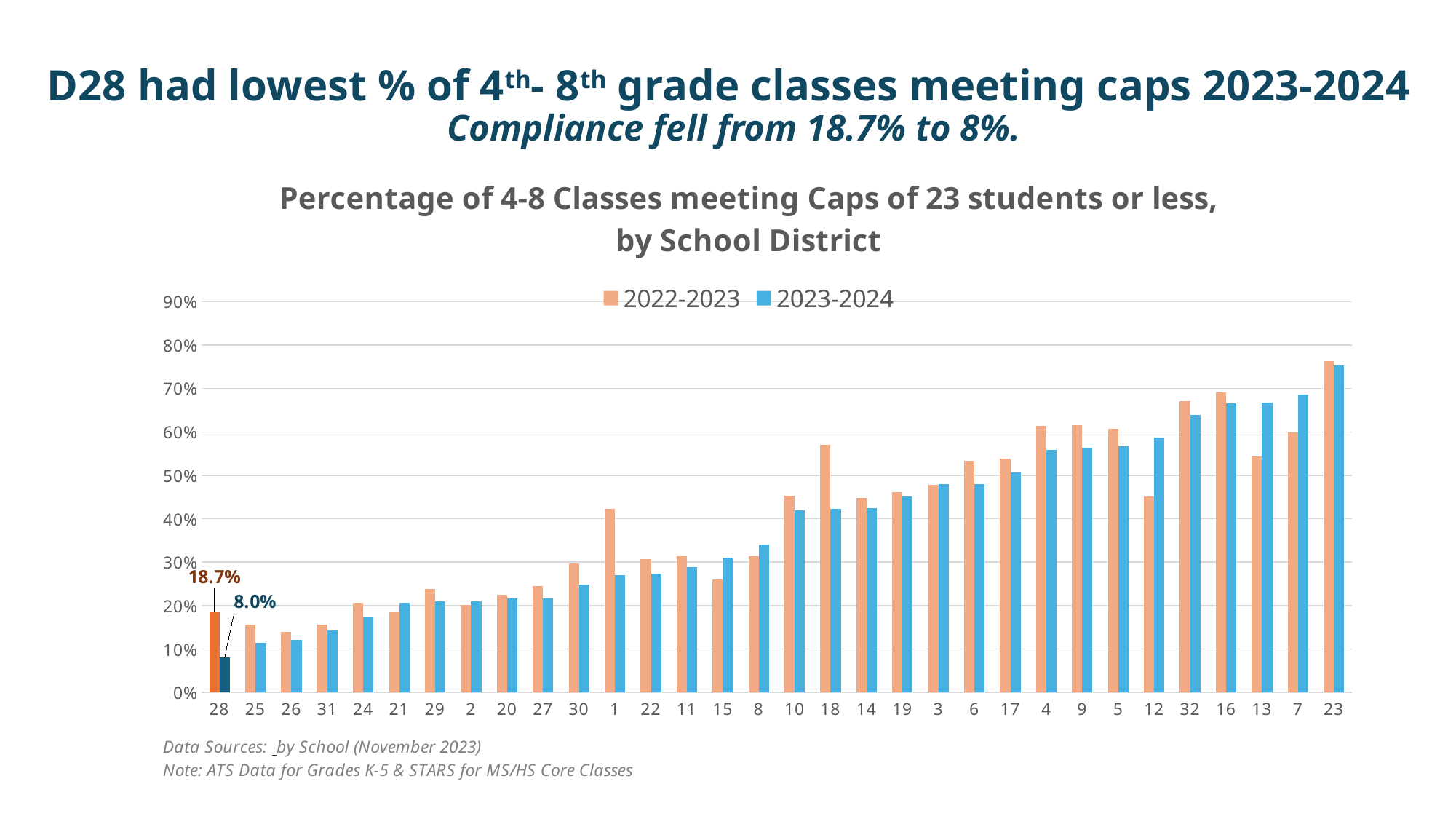
What is the 2022-2023 value for district 28? 18.7% How many series does the legend list? 2 What type of chart is shown on the slide? Bar chart How many school districts are shown on the x axis? 32 Which district has the lowest 2023-2024 value? 28 Is the 2023-2024 value for district 13 greater or less than 60%? greater Is the 2022-2023 value for district 18 greater or less than 50%? greater Which district has the highest 2023-2024 value? 23 By how many percentage points did district 28's value fall from 2022-2023 to 2023-2024? 10.7 percentage points For district 18, which series has the larger value, 2022-2023 or 2023-2024? 2022-2023 Do the values generally rise or fall moving left to right along the x axis? Rise What is the 2023-2024 value for district 28? 8.0%